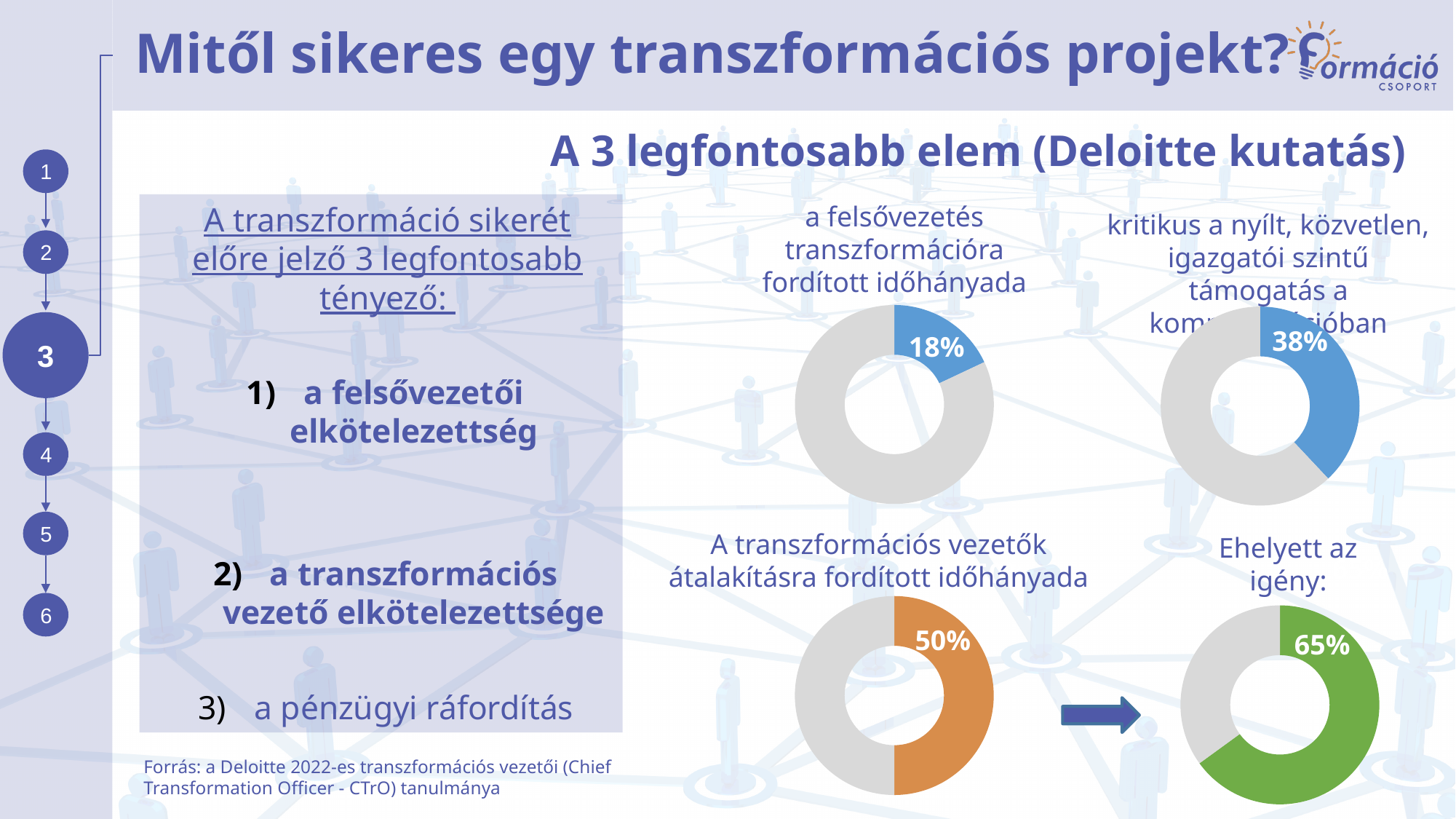
What kind of chart is used for the four percentages on the slide? Donut (pie) chart In the top-left donut chart (a felsővezetés transzformációra fordított időhányada), what percentage is shown? 18% Which donut chart shows the lowest percentage? a felsővezetés transzformációra fordított időhányada (18%) In the bottom-left donut chart (A transzformációs vezetők átalakításra fordított időhányada), what percentage is shown? 50% Which is larger: the top-right chart value (38%) or the top-left chart value (18%)? The top-right chart (38%) What colour is the highlighted segment in the bottom-right donut chart (65%)? Green How many donut charts are on the slide? 4 What is the difference between the bottom-right chart value (Ehelyett az igény) and the bottom-left chart value (A transzformációs vezetők átalakításra fordított időhányada)? 15 percentage points What colour is the highlighted segment in the bottom-left donut chart (50%)? Orange Which donut chart shows the highest percentage? Ehelyett az igény (65%) In the bottom-right donut chart (Ehelyett az igény), what percentage is shown? 65% In the top-right donut chart (kritikus a nyílt, közvetlen, igazgatói szintű támogatás), what percentage is shown? 38%